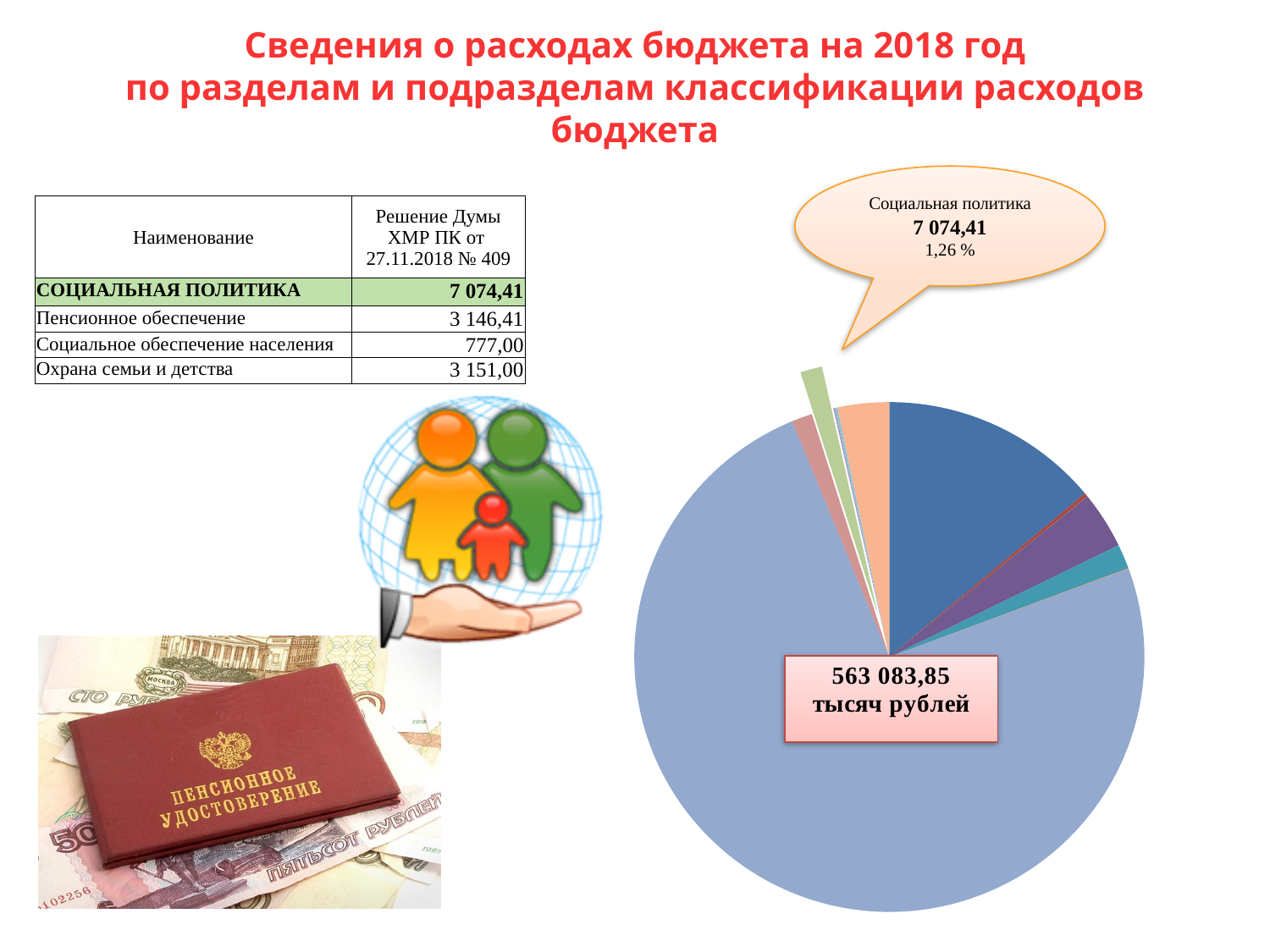
What share of the pie does Социальная политика represent, according to the callout? 1,26 % Which category is labelled by the callout pointing to the pulled-out slice of the pie chart? Социальная политика What total amount is shown in the box at the centre of the pie chart? 563 083,85 тысяч рублей Is the share of Социальная политика in the pie chart greater or less than 10%? less According to the callout on the pie chart, what is the value for Социальная политика? 7 074,41 What kind of chart is shown on the right side of the slide? pie chart